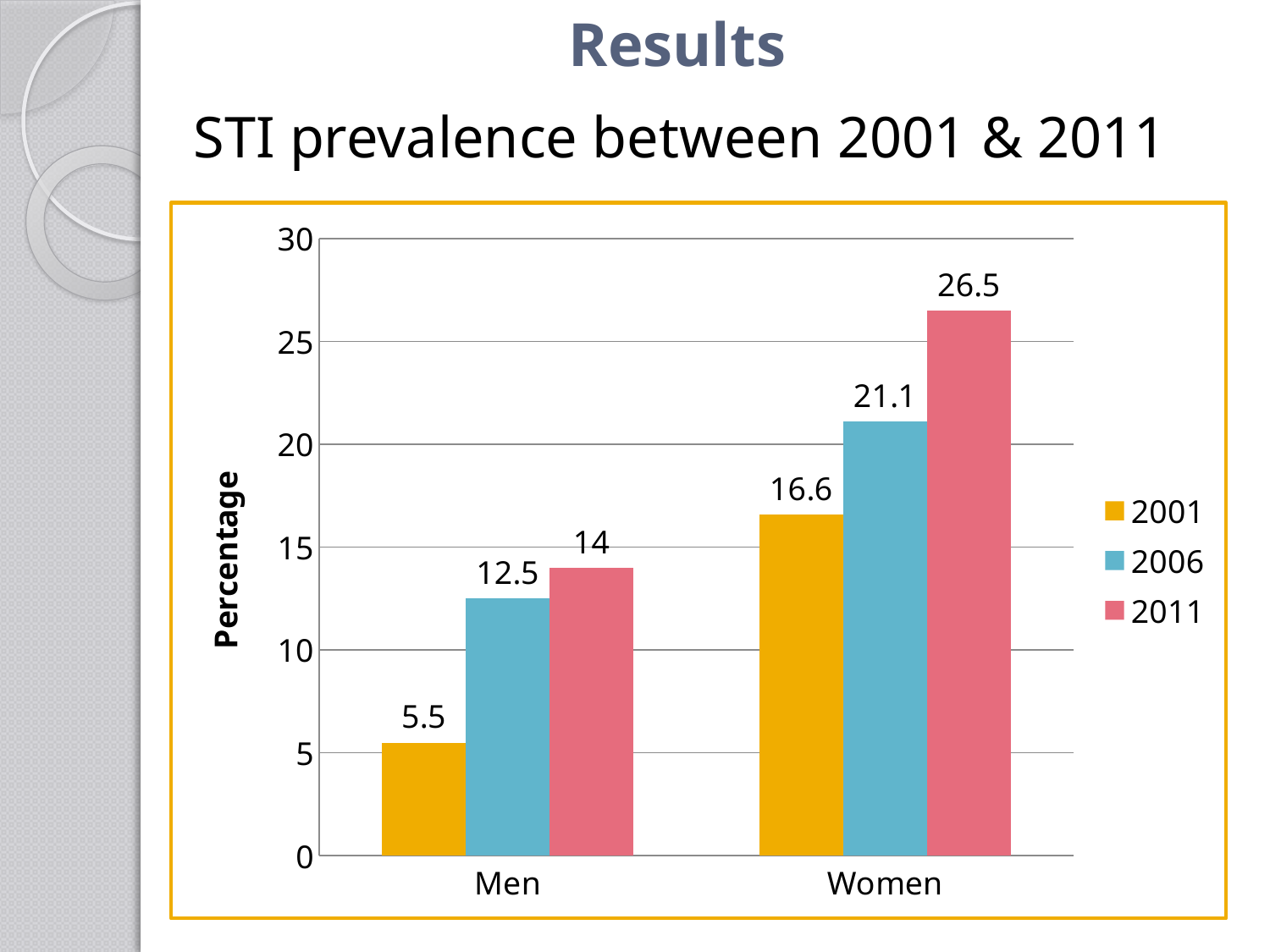
Which category has the highest value in 2011? Women Do the values for Women rise or fall from 2001 to 2011? Rise Which category has the lowest value in 2001? Men What is the value for Men in 2006? 12.5 What is the difference between the 2006 and 2001 values for Men? 7 Which is larger: the Men value in 2011 or the Women value in 2001? Women in 2001 What is the difference between the Women and Men values in 2011? 12.5 What is the value for Women in 2011? 26.5 What is the value for Men in 2001? 5.5 What is the value for Women in 2001? 16.6 What kind of chart is shown? Bar chart How many series does the legend list? 3